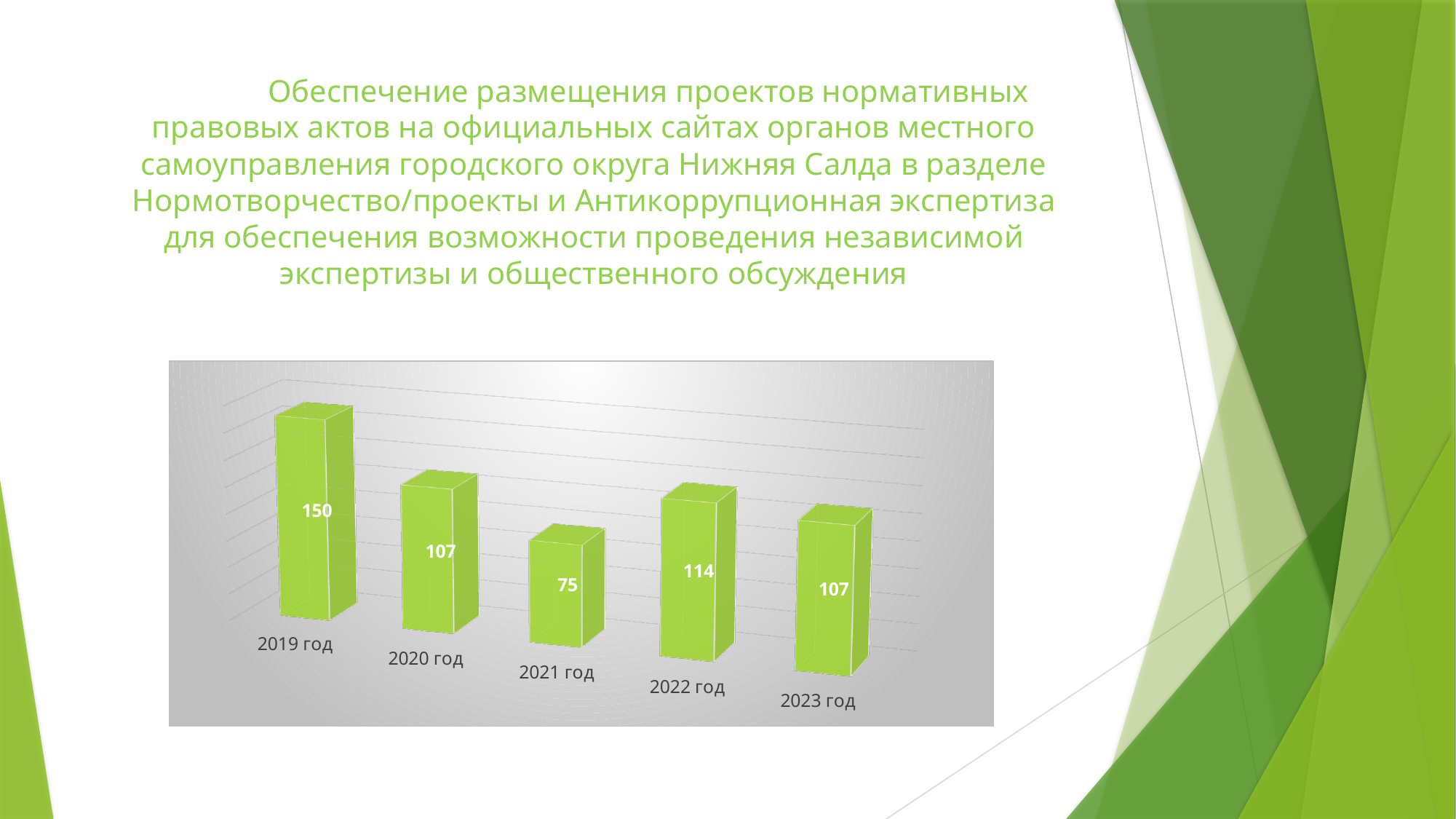
Which year has the highest value? 2019 год What kind of chart is shown on the slide? bar chart What is the difference between the values for 2022 год and 2023 год? 7 Which is larger, the value for 2020 год or the value for 2022 год? 2022 год Do the values rise or fall from 2019 год to 2021 год? fall What is the value for 2021 год? 75 What is the value for 2019 год? 150 Which year has the lowest value? 2021 год What is the value for 2022 год? 114 What is the value for 2023 год? 107 What is the difference between the values for 2019 год and 2021 год? 75 How many years are shown in the chart? 5